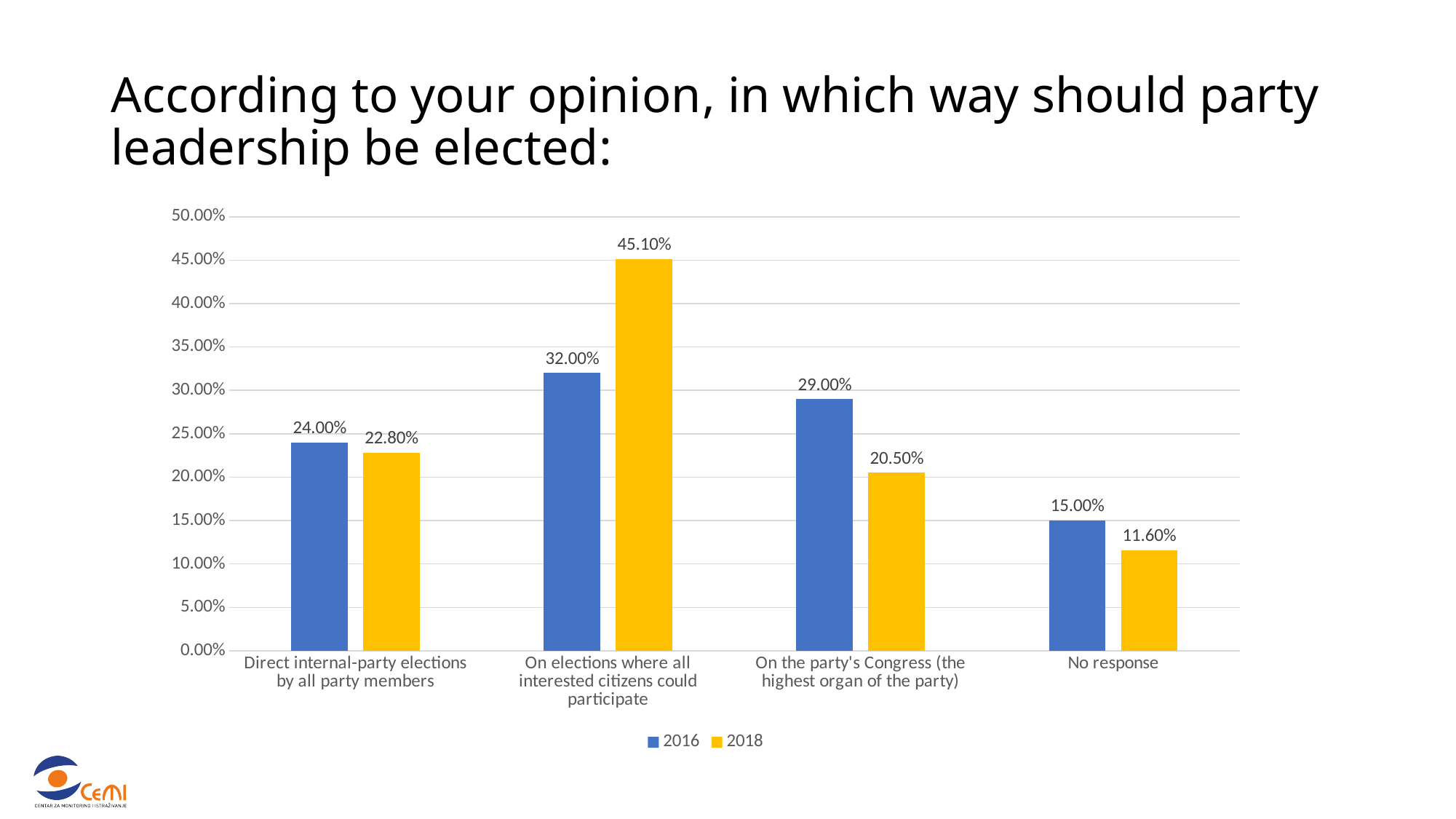
Which category has the highest 2018 value? On elections where all interested citizens could participate What is the difference between the 2016 and 2018 values for 'On the party's Congress (the highest organ of the party)'? 8.50% What kind of chart is shown on the slide? Bar chart How many series does the legend list? 2 How many categories are shown on the x axis? 4 What is the difference between the 2018 and 2016 values for 'On elections where all interested citizens could participate'? 13.10% What is the 2018 value for 'On elections where all interested citizens could participate'? 45.10% What is the 2018 value for 'No response'? 11.60% What is the 2016 value for 'On the party's Congress (the highest organ of the party)'? 29.00% Which category has the lowest 2016 value? No response Which is larger for 'Direct internal-party elections by all party members': the 2016 value or the 2018 value? 2016 What is the 2016 value for 'Direct internal-party elections by all party members'? 24.00%